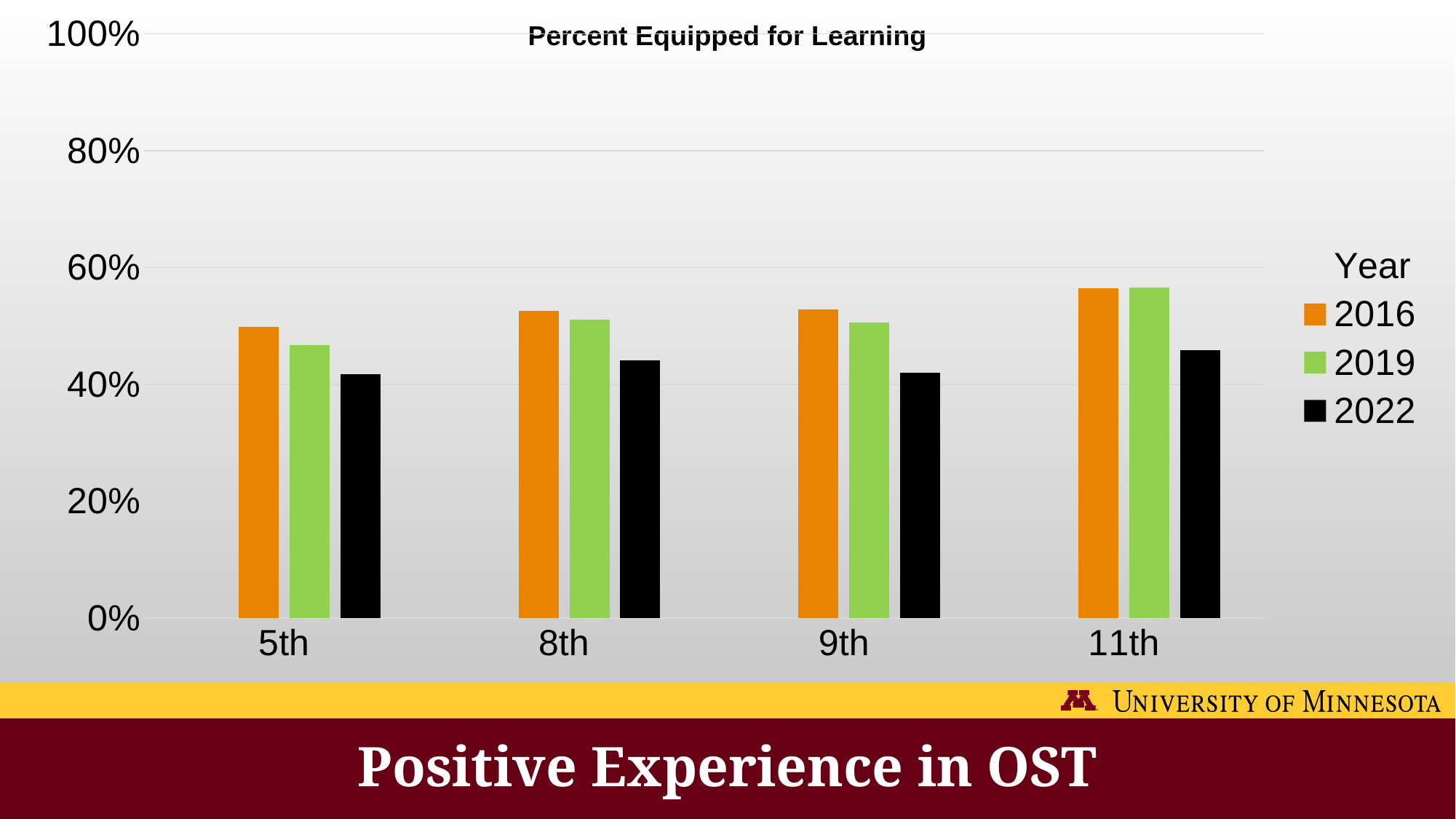
How many series does the legend list? 3 Is the 2016 value for 11th grade greater or less than 60%? less Is the 2022 value for 8th grade greater or less than 60%? less How many grade categories are shown on the x axis? 4 What is the title of the chart? Percent Equipped for Learning For 9th grade, which is larger: the 2019 value or the 2022 value? 2019 For 5th grade, which is larger: the 2016 value or the 2022 value? 2016 Which years are listed in the legend? 2016, 2019, 2022 Which grade has the lowest 2016 value? 5th Is the 2016 value for 5th grade greater or less than 40%? greater What kind of chart is shown on the slide? bar chart Which grade has the highest 2022 value? 11th